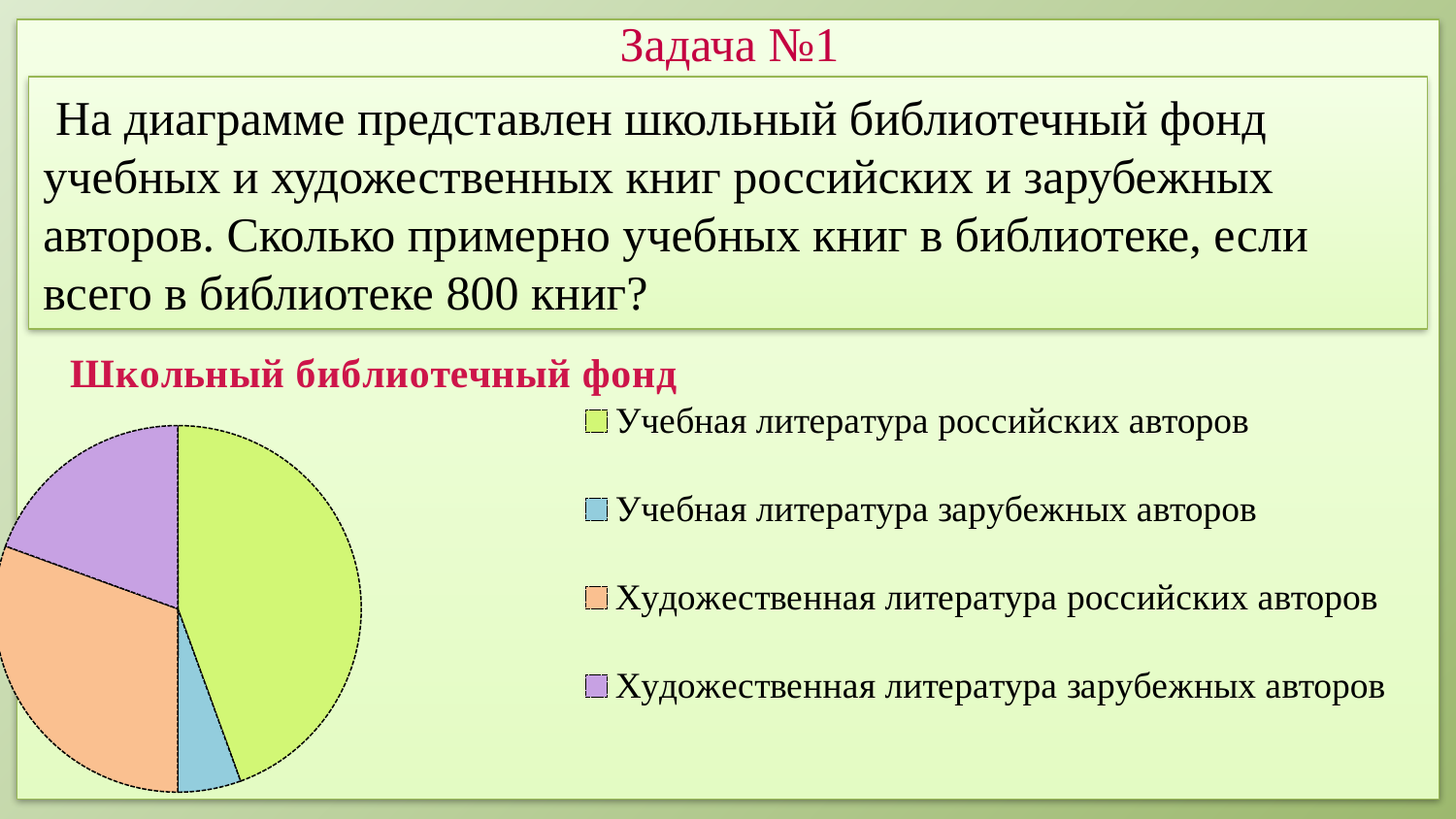
What kind of chart is shown on the slide? pie chart Which category has the largest slice of the pie? Учебная литература российских авторов How many slices does the pie chart have? 4 How many entries does the legend list? 4 What is the title of the chart? Школьный библиотечный фонд Which category has the smallest slice of the pie? Учебная литература зарубежных авторов Which slice is larger: Художественная литература российских авторов or Художественная литература зарубежных авторов? Художественная литература российских авторов Which slice is larger: Учебная литература российских авторов or Художественная литература российских авторов? Учебная литература российских авторов Which slice is larger: Художественная литература зарубежных авторов or Учебная литература зарубежных авторов? Художественная литература зарубежных авторов What colour represents Художественная литература зарубежных авторов in the pie chart? purple